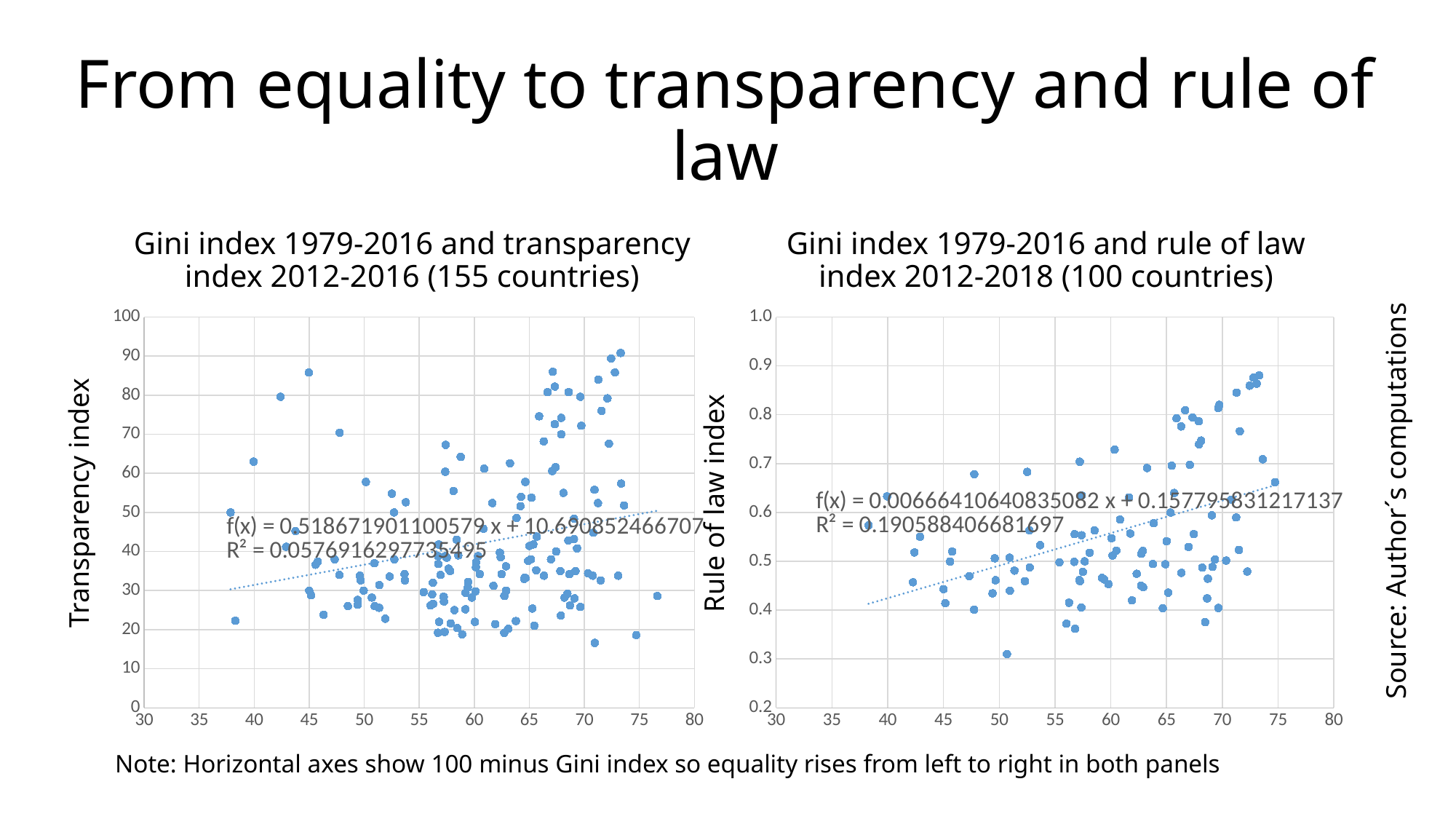
What kind of chart is the right chart, 'Gini index 1979-2016 and rule of law index 2012-2018 (100 countries)'? Scatter chart In the right chart (rule of law index), does the fitted trend line rise or fall from left to right? Rises What is the R² value shown on the left chart (transparency index)? 0.0576916297735495 What is the vertical axis label of the right chart? Rule of law index What is the R² value shown on the right chart (rule of law index)? 0.190588406681697 How many countries are plotted in the left chart, according to its title? 155 What kind of chart is the left chart, 'Gini index 1979-2016 and transparency index 2012-2016 (155 countries)'? Scatter chart What is the slope of the fitted line f(x) shown on the right chart (rule of law index)? 0.00666410640835082 How many countries are plotted in the right chart, according to its title? 100 What is the slope of the fitted line f(x) shown on the left chart (transparency index)? 0.518671901100579 In the left chart, is the highest transparency index value plotted greater or less than 80? greater In the left chart (transparency index), does the fitted trend line rise or fall as the horizontal axis value increases? Rises